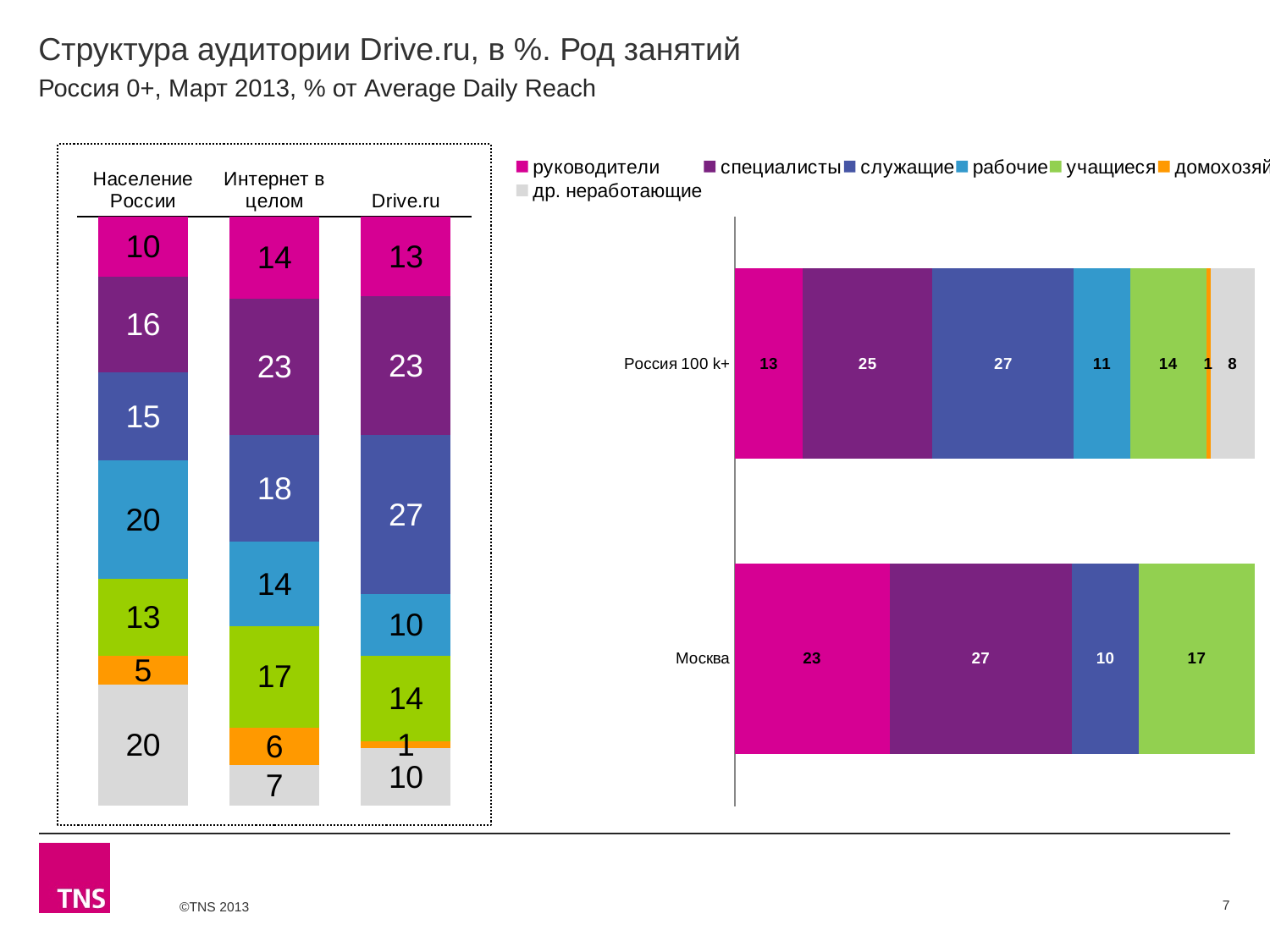
How many series does the legend on the right chart list? 7 In the right chart, what is the total of the Москва bar? 77 In the left chart, which bar has the smallest orange (домохозяйки) segment? Drive.ru In the left chart, what is the value of the grey (др. неработающие) segment in the Население России bar? 20 In the right chart, what is the difference between the служащие values for Россия 100 k+ and Москва? 17 How many bars does the left chart show? 3 In the left chart, which of the three bars has the largest pink (руководители) segment? Интернет в целом In the left chart, is the light blue (рабочие) segment larger for Население России or for Drive.ru? Население России In the right chart, what is the value for руководители in the Москва bar? 23 In the left chart, what is the value of the dark blue (служащие) segment in the Drive.ru bar? 27 What type of chart is the right chart? Stacked bar chart In the right chart, what is the value for специалисты in the Россия 100 k+ bar? 25